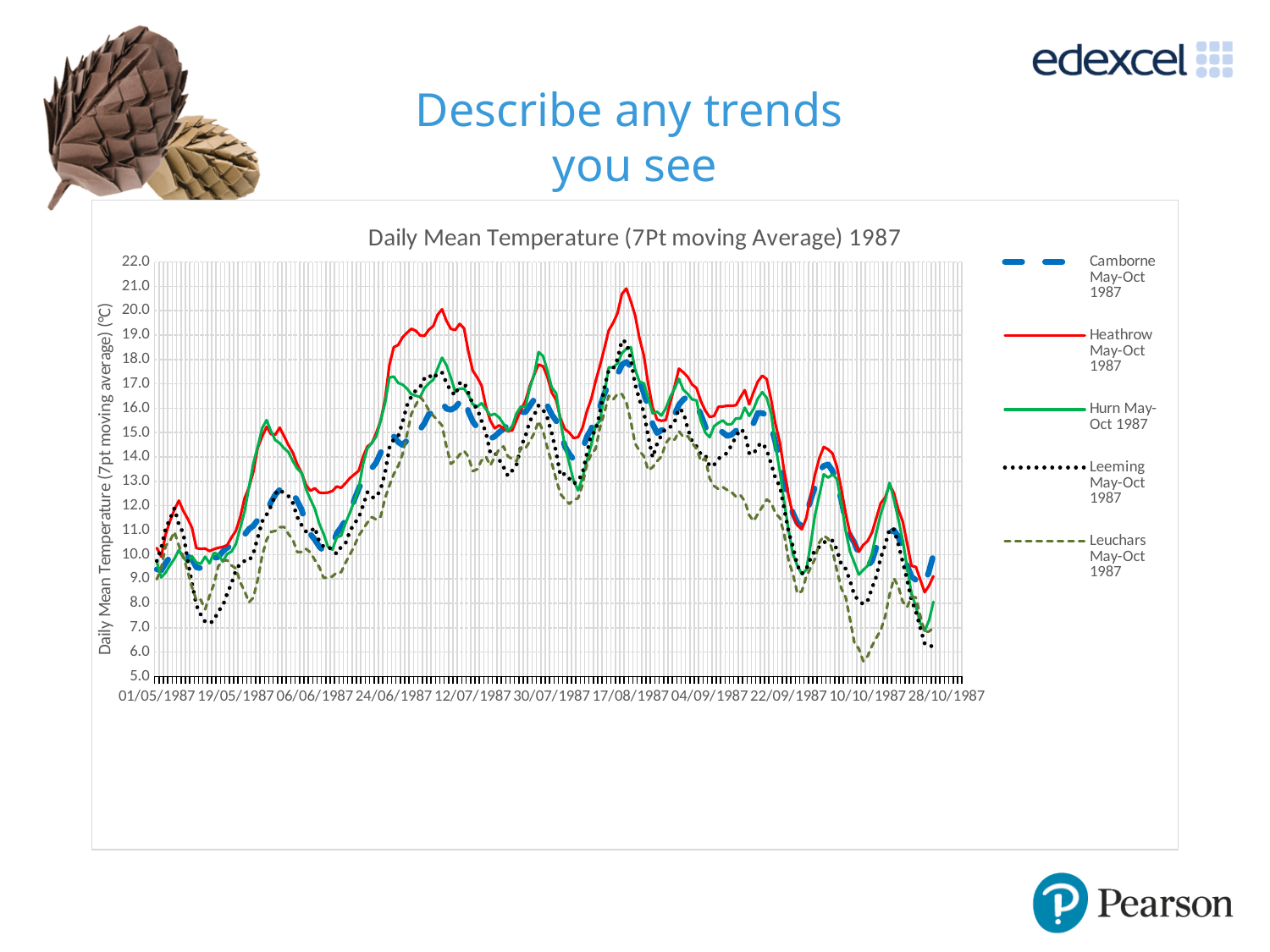
From 01/05/1987 to 12/07/1987, do the temperatures generally rise or fall? rise Is the highest value reached by Leuchars May-Oct 1987 greater or less than 18.0? less At the peak around 17/08/1987, which is higher: Heathrow May-Oct 1987 or Leuchars May-Oct 1987? Heathrow May-Oct 1987 Which series is drawn as a thick dashed blue line? Camborne May-Oct 1987 Is the lowest value reached by Leuchars May-Oct 1987 greater or less than 7.0? less Is the highest value reached by Heathrow May-Oct 1987 greater or less than 20.0? greater From 22/09/1987 to 28/10/1987, do the temperatures generally rise or fall? fall What is the title of the chart? Daily Mean Temperature (7Pt moving Average) 1987 Which series reaches the highest temperature on the chart? Heathrow May-Oct 1987 How many series does the legend list? 5 What kind of chart is shown on the slide? line chart Which series falls to the lowest temperature on the chart? Leuchars May-Oct 1987